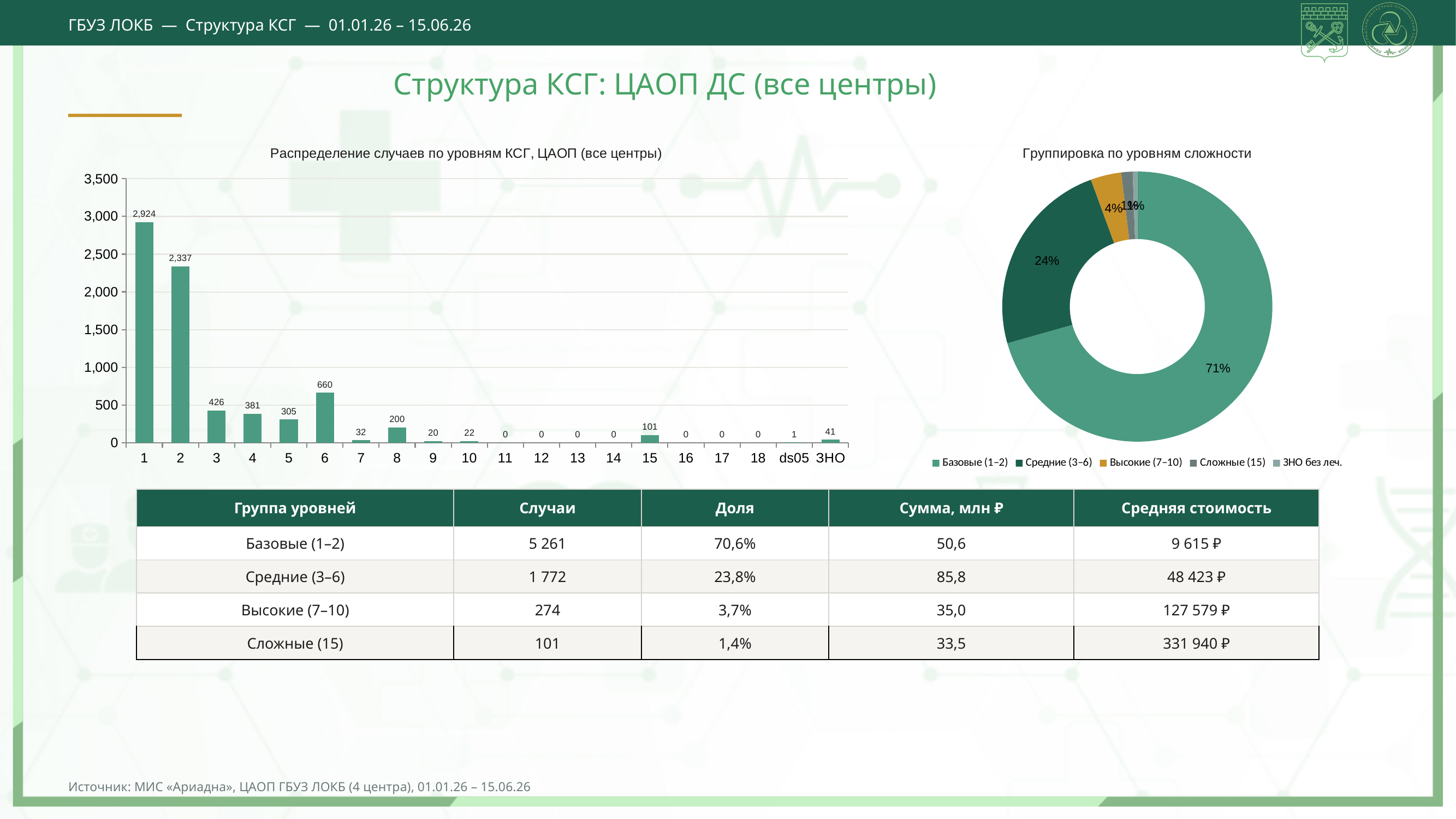
What kind of chart is 'Распределение случаев по уровням КСГ, ЦАОП (все центры)'? bar chart How many entries does the legend of the chart 'Группировка по уровням сложности' list? 5 In the bar chart 'Распределение случаев по уровням КСГ, ЦАОП (все центры)', what is the value for category 1? 2,924 In the bar chart 'Распределение случаев по уровням КСГ, ЦАОП (все центры)', which is larger: the value for category 3 or category 4? 3 In the bar chart 'Распределение случаев по уровням КСГ, ЦАОП (все центры)', what is the difference between the values for categories 1 and 2? 587 How many categories are shown on the x axis of the bar chart 'Распределение случаев по уровням КСГ, ЦАОП (все центры)'? 20 In the chart 'Группировка по уровням сложности', what share does 'Базовые (1–2)' have? 71% In the bar chart 'Распределение случаев по уровням КСГ, ЦАОП (все центры)', which category has the highest value? 1 In the bar chart 'Распределение случаев по уровням КСГ, ЦАОП (все центры)', what is the value for category 6? 660 In the chart 'Группировка по уровням сложности', what share does 'Средние (3–6)' have? 24% In the bar chart 'Распределение случаев по уровням КСГ, ЦАОП (все центры)', is the value for category 2 greater or less than 2,000? greater In the bar chart 'Распределение случаев по уровням КСГ, ЦАОП (все центры)', what is the value for category 15? 101